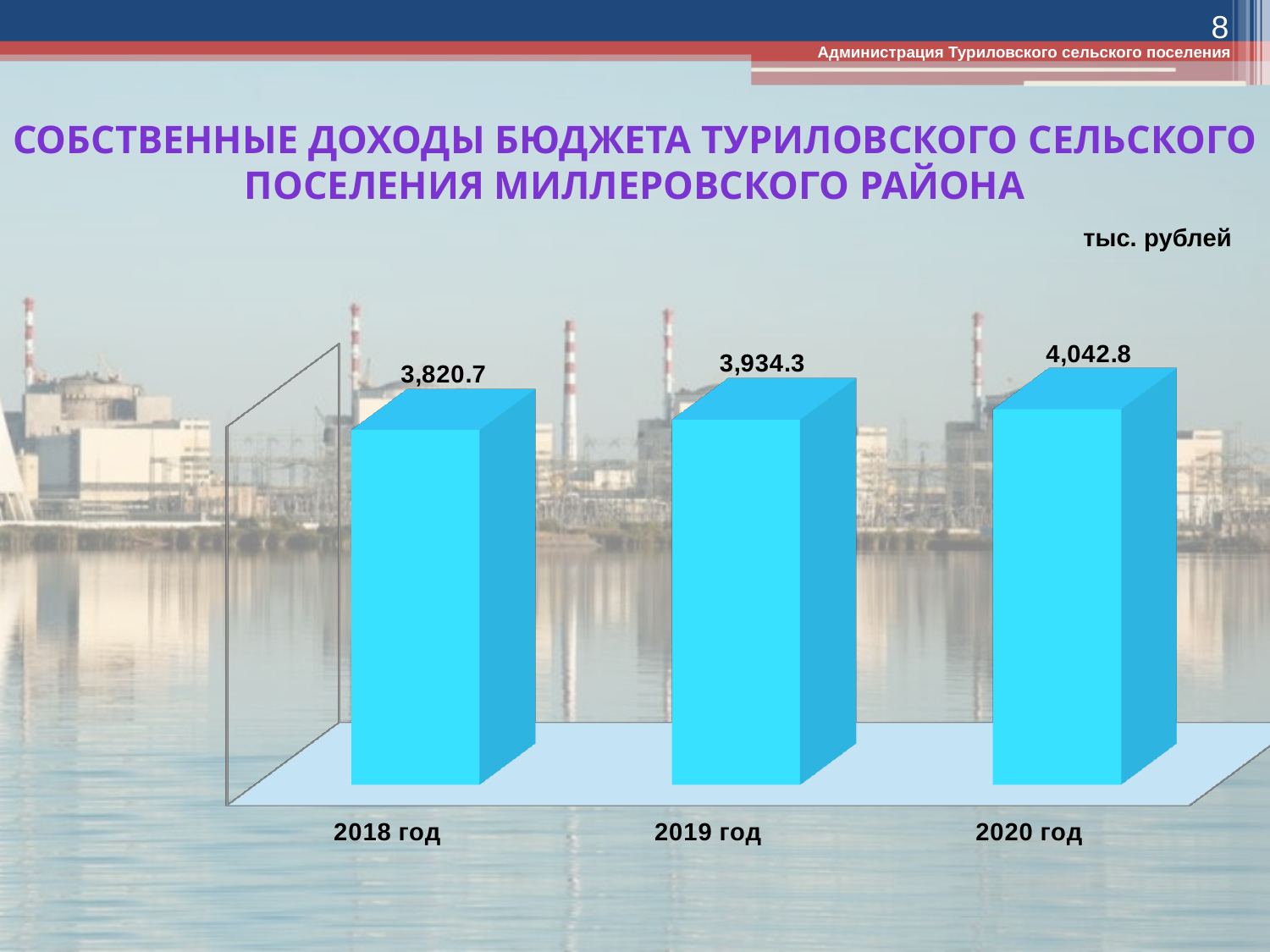
What is the value for 2020 год? 4,042.8 What is the value for 2019 год? 3,934.3 Which year has the lowest value? 2018 год Which year has the highest value? 2020 год Which is larger, the value for 2019 год or the value for 2020 год? 2020 год How many years are shown on the chart? 3 In what units are the chart values given? тыс. рублей What is the value for 2018 год? 3,820.7 What kind of chart is shown on the slide? bar chart What is the difference between the values for 2020 год and 2018 год? 222.1 Do the values rise or fall from 2018 год to 2020 год? rise What is the difference between the values for 2019 год and 2018 год? 113.6